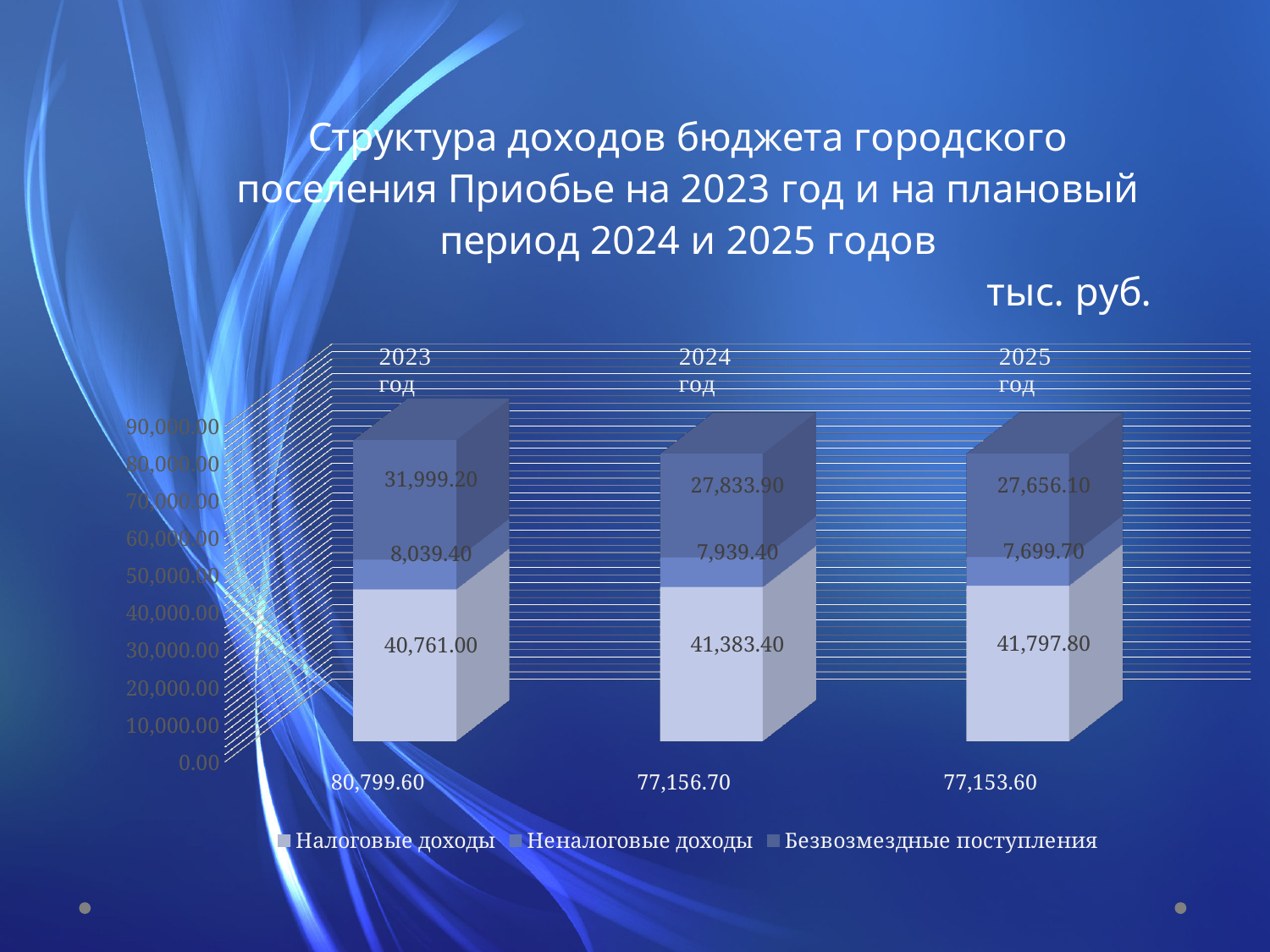
Which is larger: Безвозмездные поступления in 2024 год or in 2025 год? 2024 год Which year has the highest value for Безвозмездные поступления? 2023 год How many years (categories) are shown on the chart? 3 Do the values for Налоговые доходы rise or fall from 2023 год to 2025 год? Rise What is the value of Безвозмездные поступления for 2025 год? 27,656.10 What is the total of the stacked bar for 2024 год? 77,156.70 What kind of chart is shown on the slide? Stacked bar chart What is the value of Налоговые доходы for 2023 год? 40,761.00 Which year has the lowest value for Неналоговые доходы? 2025 год How many series does the legend list? 3 What is the value of Неналоговые доходы for 2024 год? 7,939.40 What is the difference between Налоговые доходы in 2025 год and in 2023 год? 1,036.80